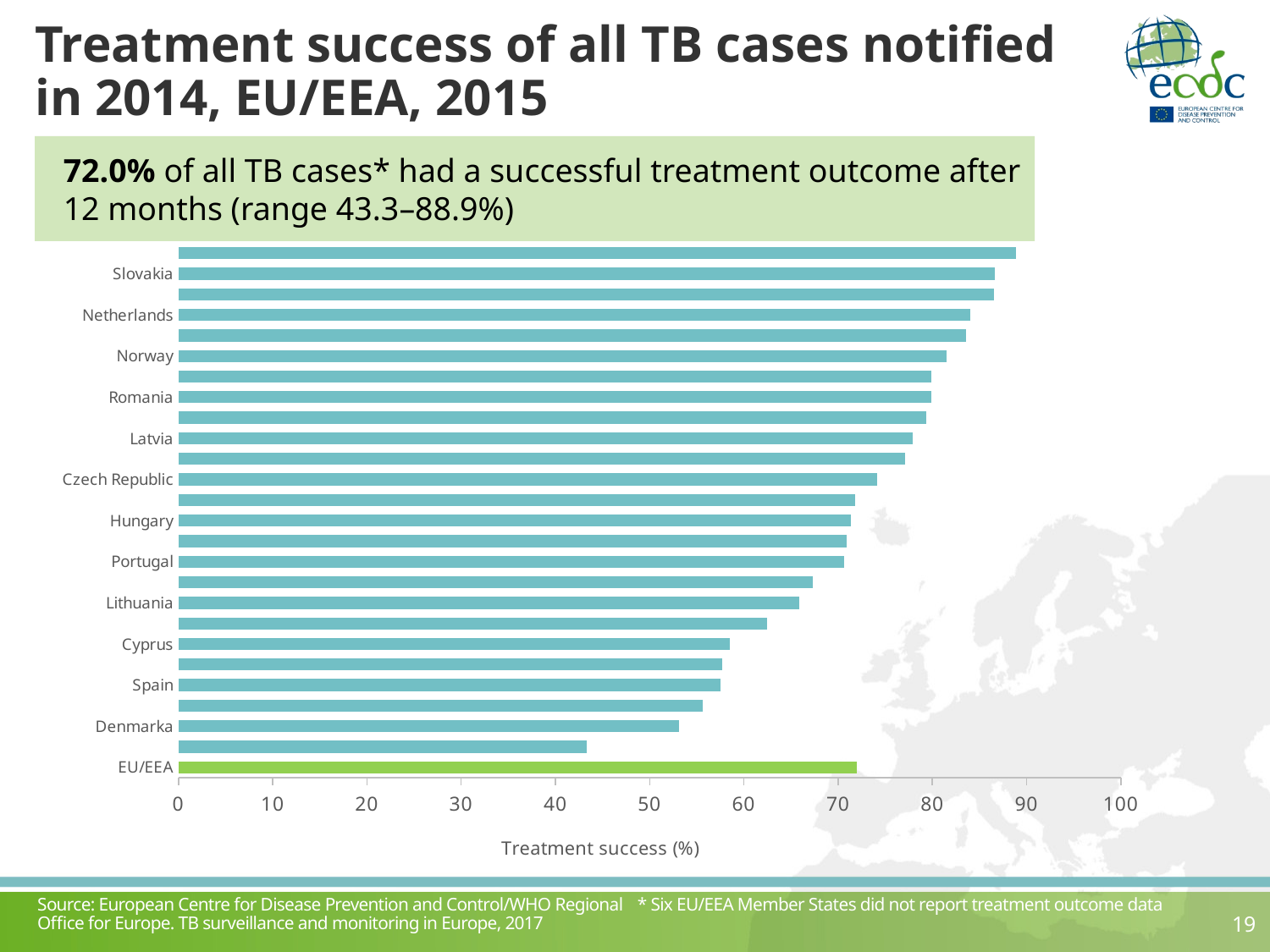
Is the value for Czech Republic greater or less than 70? greater Is the value for Lithuania greater or less than 70? less What kind of chart is shown on the slide? bar chart Is the value for Netherlands greater or less than 80? greater Which has a higher treatment success, Latvia or Cyprus? Latvia What is the title of the horizontal axis? Treatment success (%) Which has a higher treatment success, Slovakia or Denmark? Slovakia What is the treatment success value for EU/EEA? 72.0%